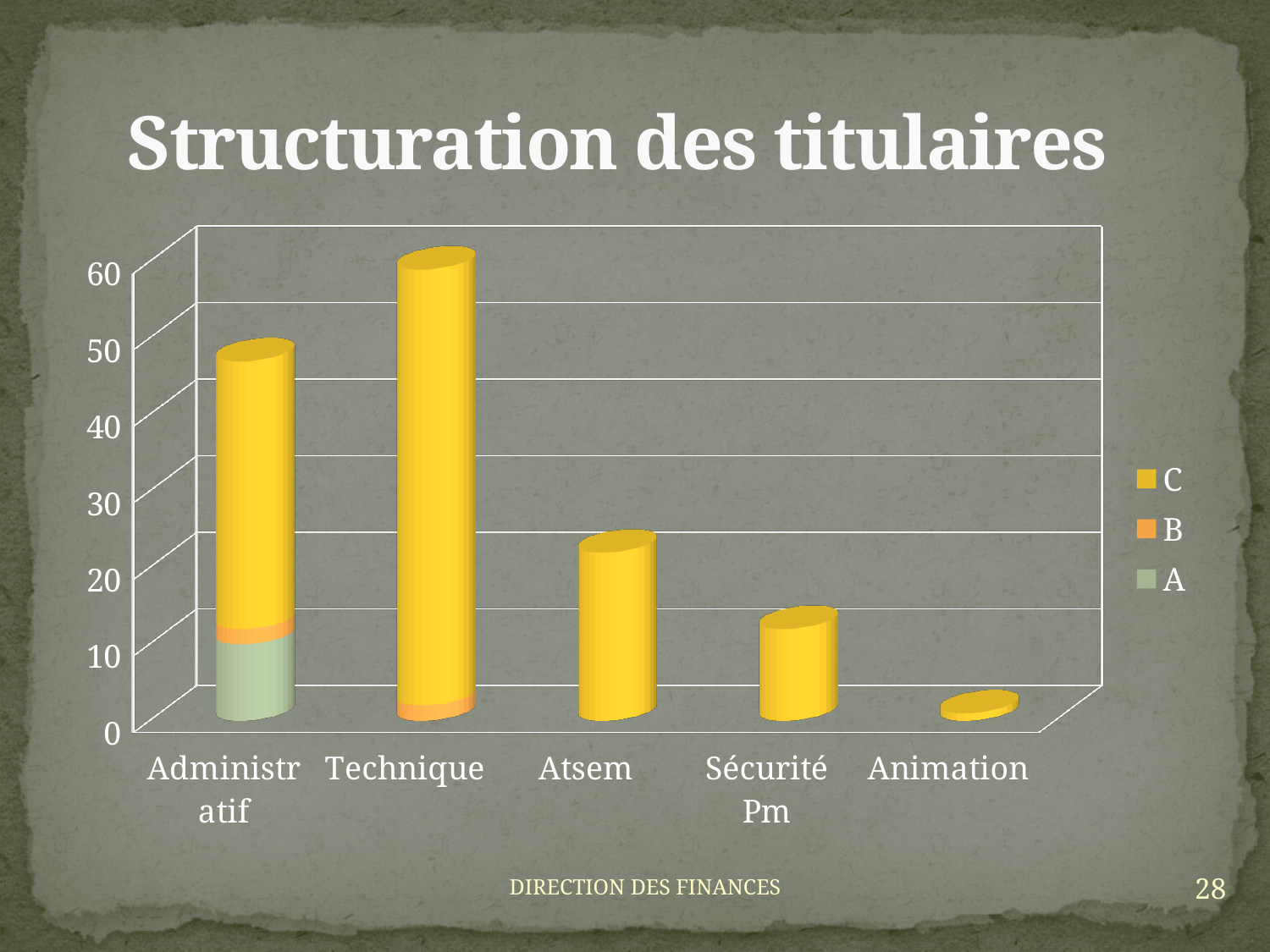
How many categories are shown on the x axis of the chart? 5 Is the total value for Technique greater or less than 50? greater What kind of chart is shown on the slide? Stacked bar chart From Technique to Animation, do the bar heights rise or fall along the x axis? fall Is the value for Atsem greater or less than 30? less What is the title of the chart? Structuration des titulaires Is the value for Animation greater or less than 10? less Which bar is taller, Atsem or Sécurité Pm? Atsem Which bar is taller, Administratif or Technique? Technique Which category has the tallest bar? Technique How many series does the legend list? 3 Which category has the shortest bar? Animation